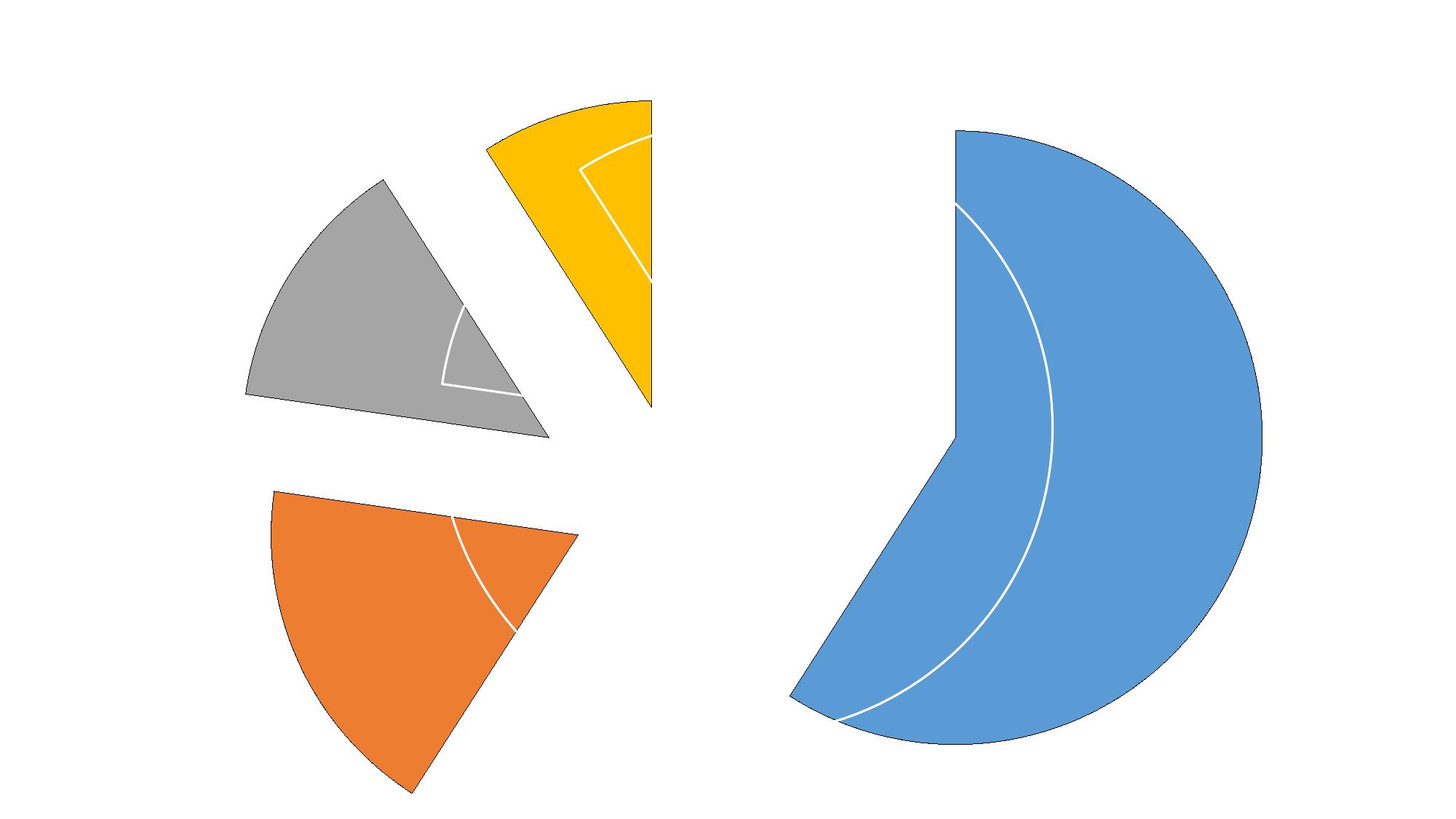
How many slices does the pie chart have? 4 What kind of chart is shown on the slide? pie chart Which is larger in the pie chart, the orange slice or the yellow slice? the orange slice Are the slices of the pie chart separated (exploded) from each other? yes What colours are the slices of the pie chart? blue, orange, gray and yellow Which slice of the pie chart is the largest? the blue slice Which is larger in the pie chart, the blue slice or the orange slice? the blue slice